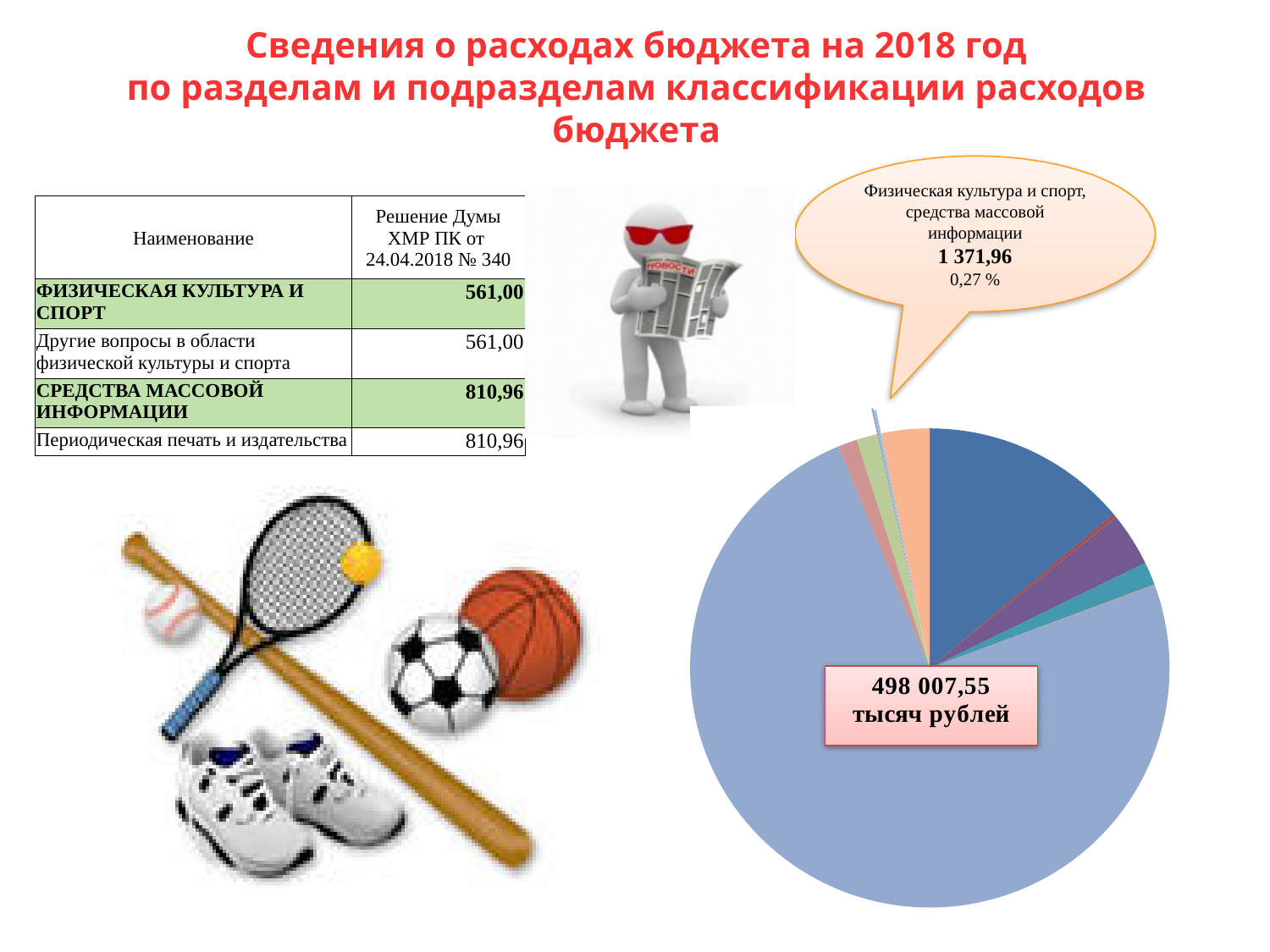
What share of the pie does the callout give for "Физическая культура и спорт, средства массовой информации"? 0,27 % What total amount is printed in the box on the pie chart? 498 007,55 тысяч рублей Does the pie chart have a legend? No According to the callout on the pie chart, what is the value for "Физическая культура и спорт, средства массовой информации"? 1 371,96 Is the share of the pie for "Физическая культура и спорт, средства массовой информации" greater or less than 1 %? less What kind of chart is shown on the right side of the slide? pie chart What colour is the largest slice of the pie chart? light blue